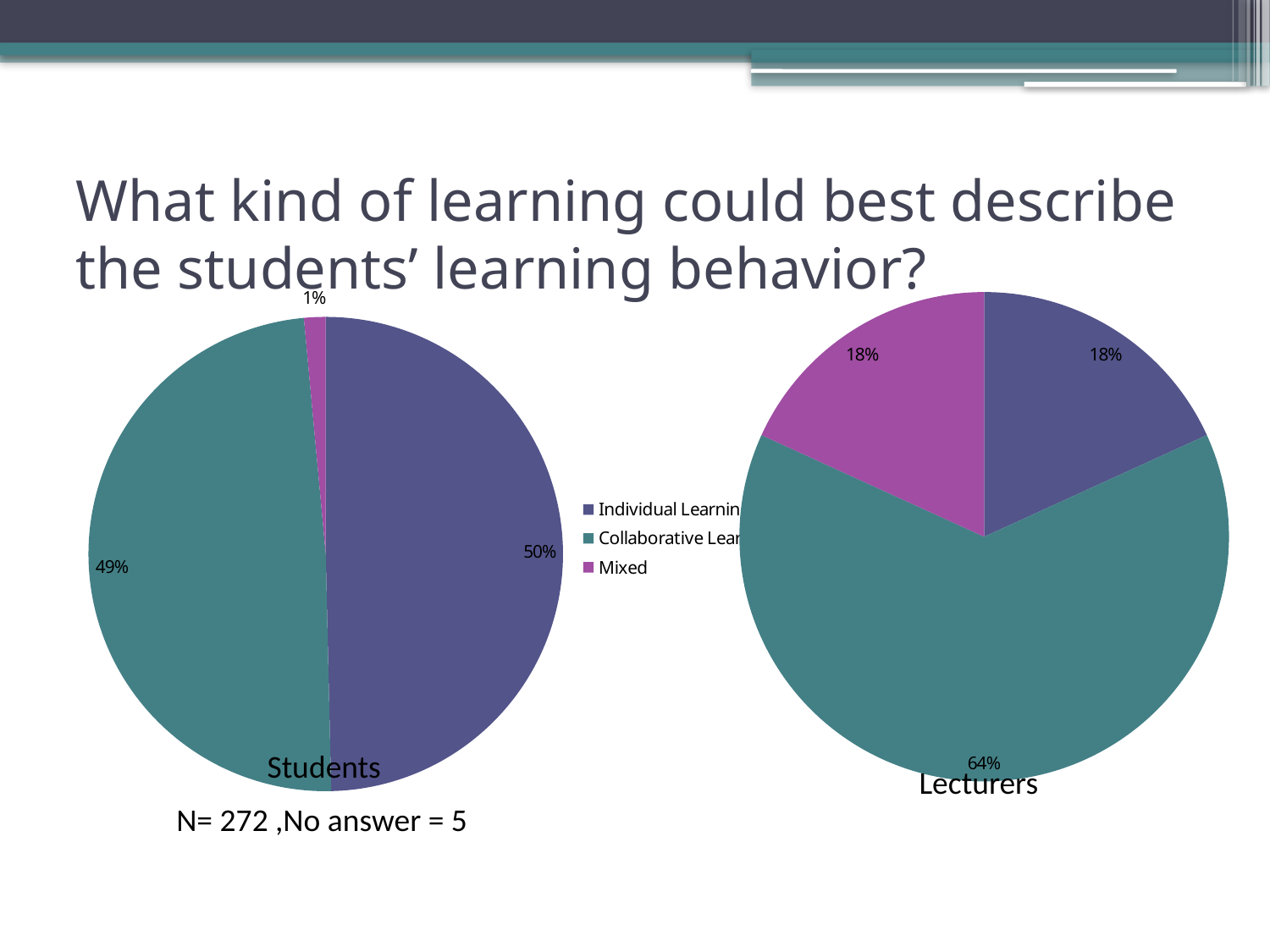
How many entries does the legend between the two charts list? 3 In the Students pie chart, what percentage is shown for Mixed? 1% In the Students pie chart, what percentage is shown for Individual Learning? 50% In the Lecturers pie chart, which category has the largest slice? Collaborative Learning How many slices does the Students pie chart have? 3 In the Students pie chart, which category has the smallest slice? Mixed In the Lecturers pie chart, what percentage is shown for Collaborative Learning? 64% In the Lecturers pie chart, what percentage is shown for Individual Learning? 18% Is the Mixed share larger in the Students pie chart or the Lecturers pie chart? Lecturers In the Lecturers pie chart, what is the difference in percentage points between Collaborative Learning and Individual Learning? 46 percentage points In the Students pie chart, what is the difference in percentage points between Individual Learning and Collaborative Learning? 1 percentage point What type of chart is used for the Lecturers data? Pie chart